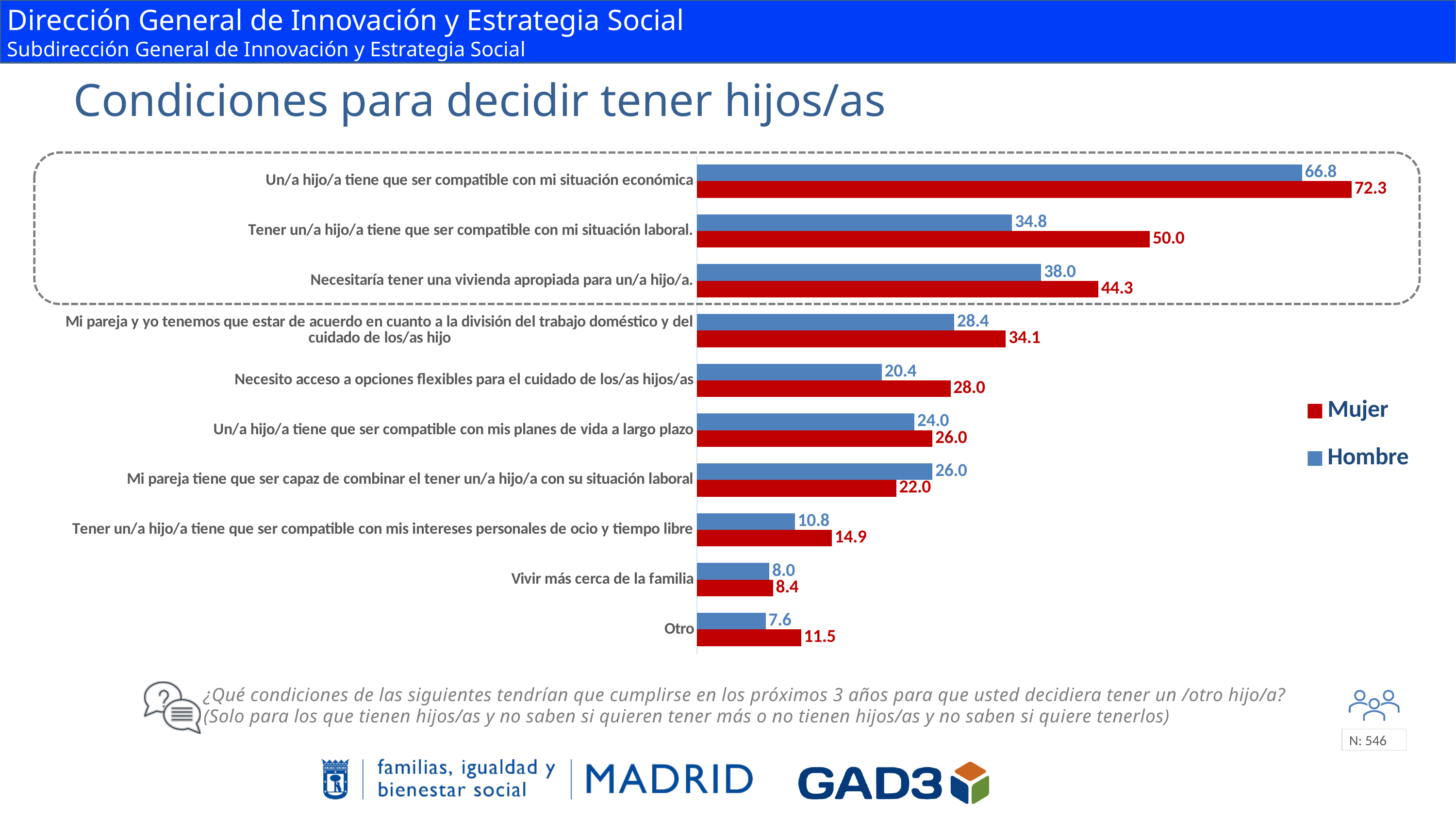
Which category has the highest Hombre value? Un/a hijo/a tiene que ser compatible con mi situación económica Which colour represents the Mujer series in the chart? Red Which category has the lowest Mujer value? Vivir más cerca de la familia For "Mi pareja tiene que ser capaz de combinar el tener un/a hijo/a con su situación laboral", which series has the larger value, Mujer or Hombre? Hombre How many series does the legend list? 2 What is the Hombre value for "Otro"? 7.6 How many categories are shown in the chart? 10 What is the difference between the Mujer and Hombre values for "Tener un/a hijo/a tiene que ser compatible con mi situación laboral."? 15.2 What is the Mujer value for "Vivir más cerca de la familia"? 8.4 What is the Mujer value for "Un/a hijo/a tiene que ser compatible con mi situación económica"? 72.3 What type of chart is shown on the slide? Bar chart What is the Hombre value for "Tener un/a hijo/a tiene que ser compatible con mi situación laboral."? 34.8